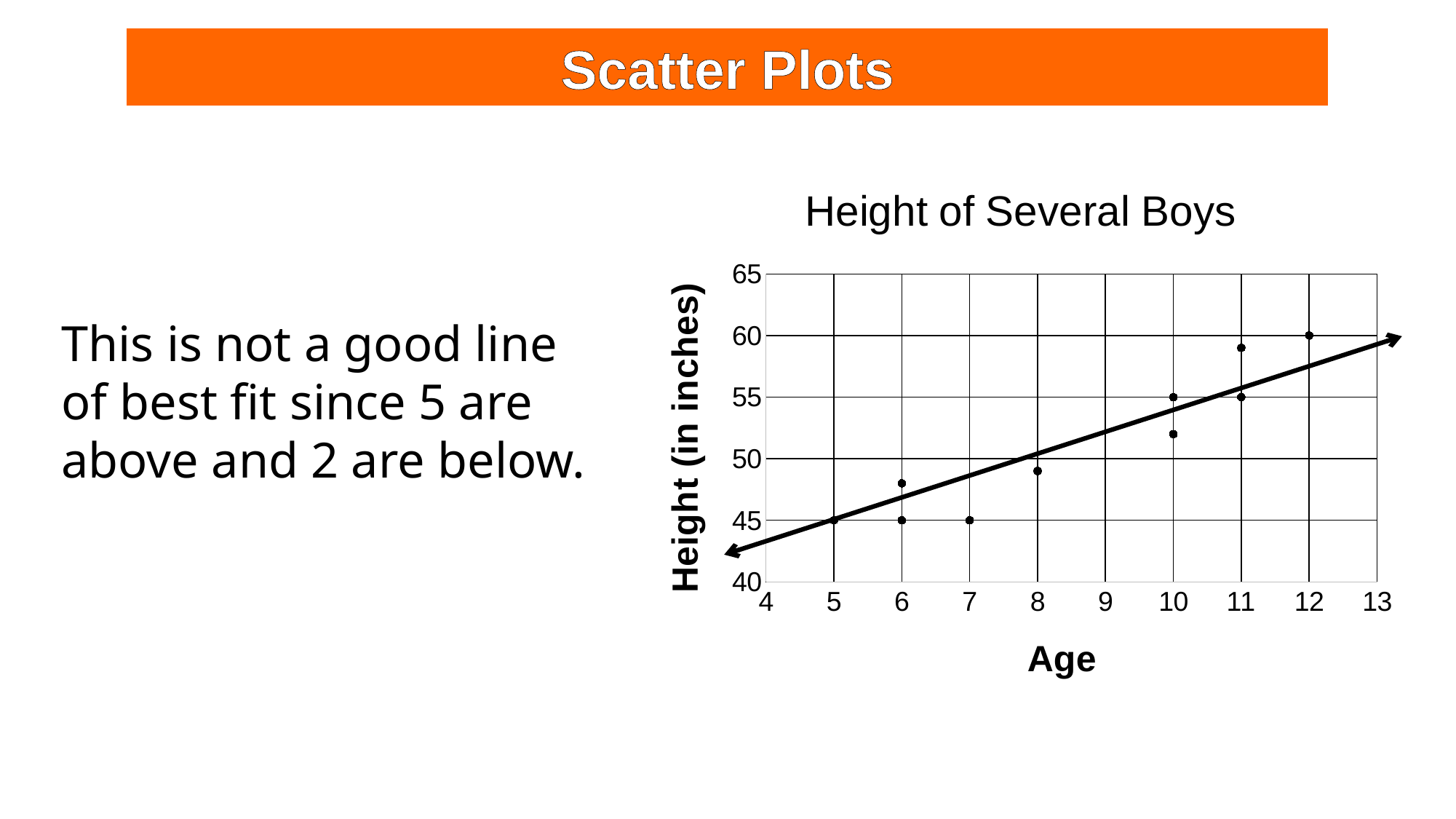
Is the height for the boy aged 8 greater or less than 50? less Is the higher of the two points at age 11 greater or less than 55? greater What is the height plotted for the boy aged 7? 45 Do the plotted heights generally rise or fall as age increases? rise At which age is the highest point plotted? 12 How many data points are plotted on the chart? 10 What is the title of the chart? Height of Several Boys What kind of chart is shown on the slide? scatter plot What is the difference between the height at age 12 and the height at age 5? 15 What is the height plotted for the boy aged 5? 45 What is the label of the vertical axis? Height (in inches) What is the height plotted for the boy aged 12? 60